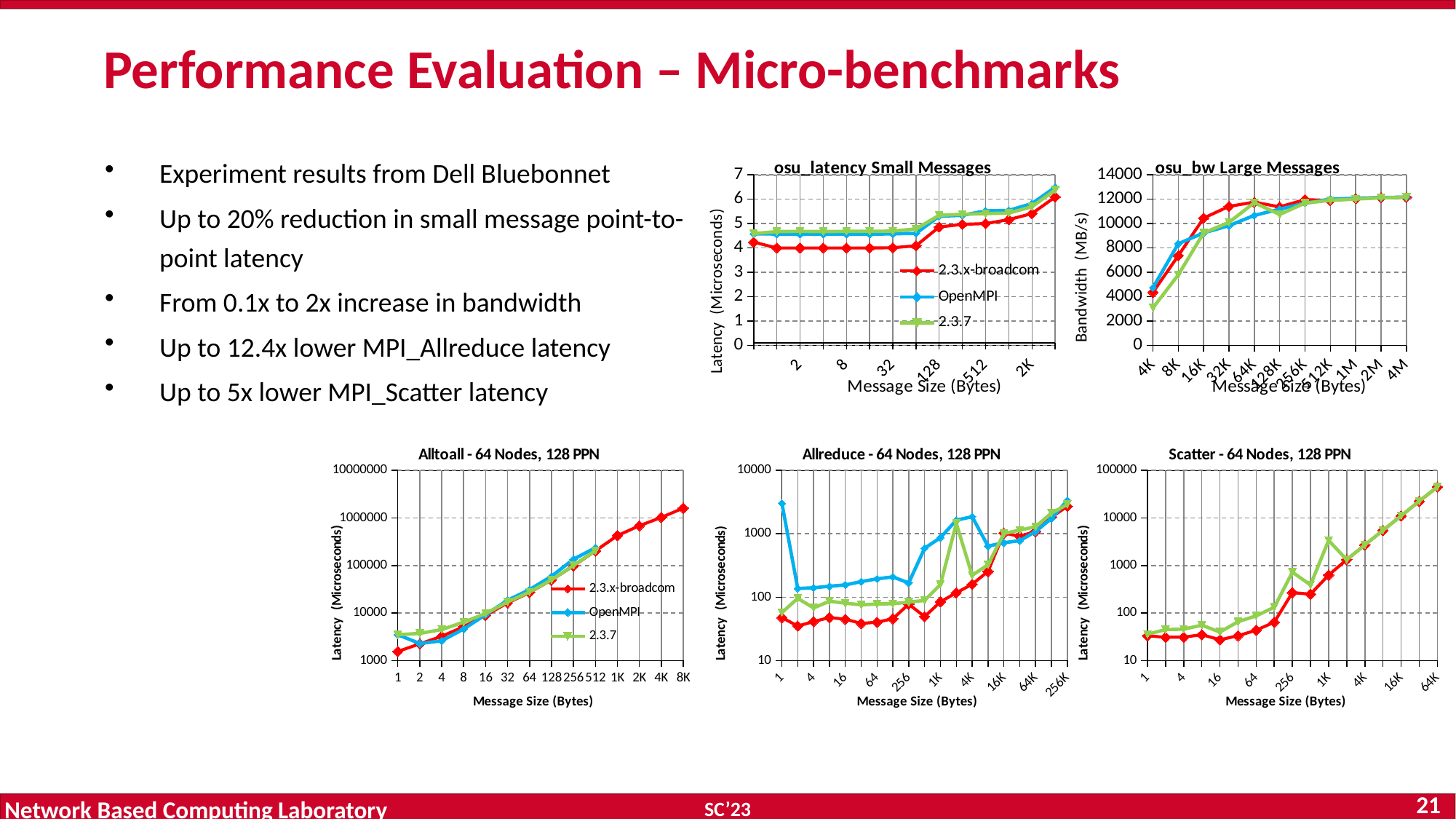
In the "osu_latency Small Messages" chart, is the 2.3.7 latency at message size 2K greater or less than 5? greater What is the y-axis label of the "osu_bw Large Messages" chart? Bandwidth (MB/s) How many series does the legend of the "osu_latency Small Messages" chart list? 3 In the "osu_bw Large Messages" chart, is the 2.3.x-broadcom bandwidth at message size 4M greater or less than 10000? greater In the "osu_bw Large Messages" chart, do the bandwidth values generally rise or fall as message size increases? rise In the "Alltoall - 64 Nodes, 128 PPN" chart, is the 2.3.x-broadcom latency at message size 8K greater or less than 1000000? greater What kind of chart is the "osu_latency Small Messages" chart? line chart How many message-size tick labels are shown on the x axis of the "Alltoall - 64 Nodes, 128 PPN" chart? 14